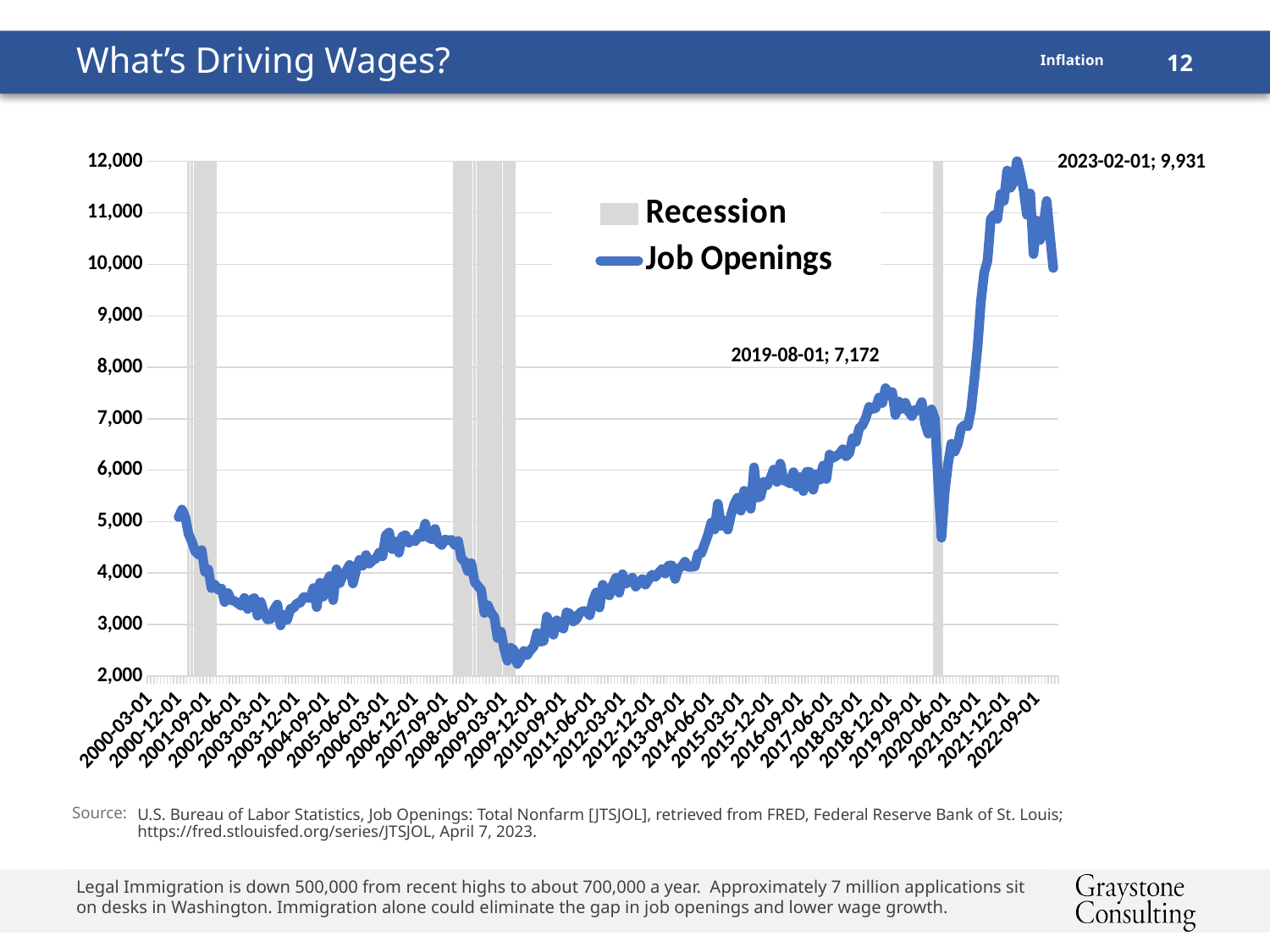
Which labeled point has the higher Job Openings value, 2019-08-01 or 2023-02-01? 2023-02-01 Is the Job Openings value at the sharp dip in 2020 greater or less than 6,000? less What is the difference between the labeled Job Openings values for 2023-02-01 and 2019-08-01? 2,759 Is the peak Job Openings value reached in 2022 greater or less than 11,000? greater What is the labeled value of Job Openings on 2019-08-01? 7,172 How many entries does the chart legend list? 2 Is the Job Openings value at its lowest point around 2009 greater or less than 3,000? less Do Job Openings generally rise or fall between 2009-12-01 and 2019-08-01? Rise What is the labeled value of Job Openings on 2023-02-01? 9,931 How many grey shaded recession periods are shown on the chart? 3 What do the grey shaded areas on the chart represent, according to the legend? Recession What kind of chart is shown on the slide? Line chart